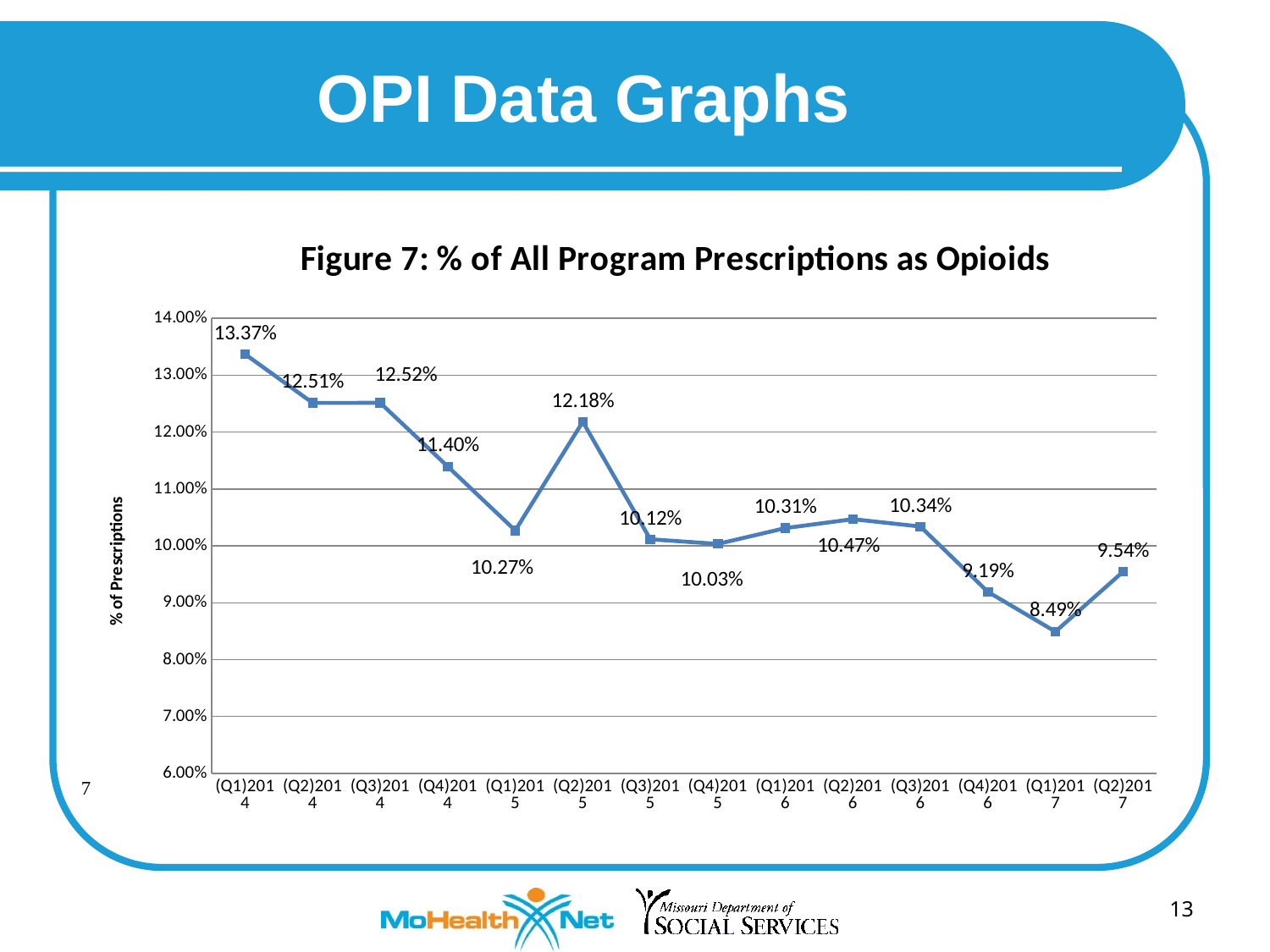
Which quarter has the highest value? (Q1)2014 What is the title of the chart? Figure 7: % of All Program Prescriptions as Opioids What is the value for (Q1)2014? 13.37% What is the label of the vertical axis? % of Prescriptions Which is larger, the value for (Q4)2014 or the value for (Q2)2015? (Q2)2015 What is the value for (Q1)2017? 8.49% What type of chart is shown on the slide? line chart How many data points are plotted on the chart? 14 Overall, do the values rise or fall from (Q1)2014 to (Q2)2017? fall Which quarter has the lowest value? (Q1)2017 What is the difference between the values for (Q1)2014 and (Q1)2017? 4.88% What is the value for (Q2)2015? 12.18%